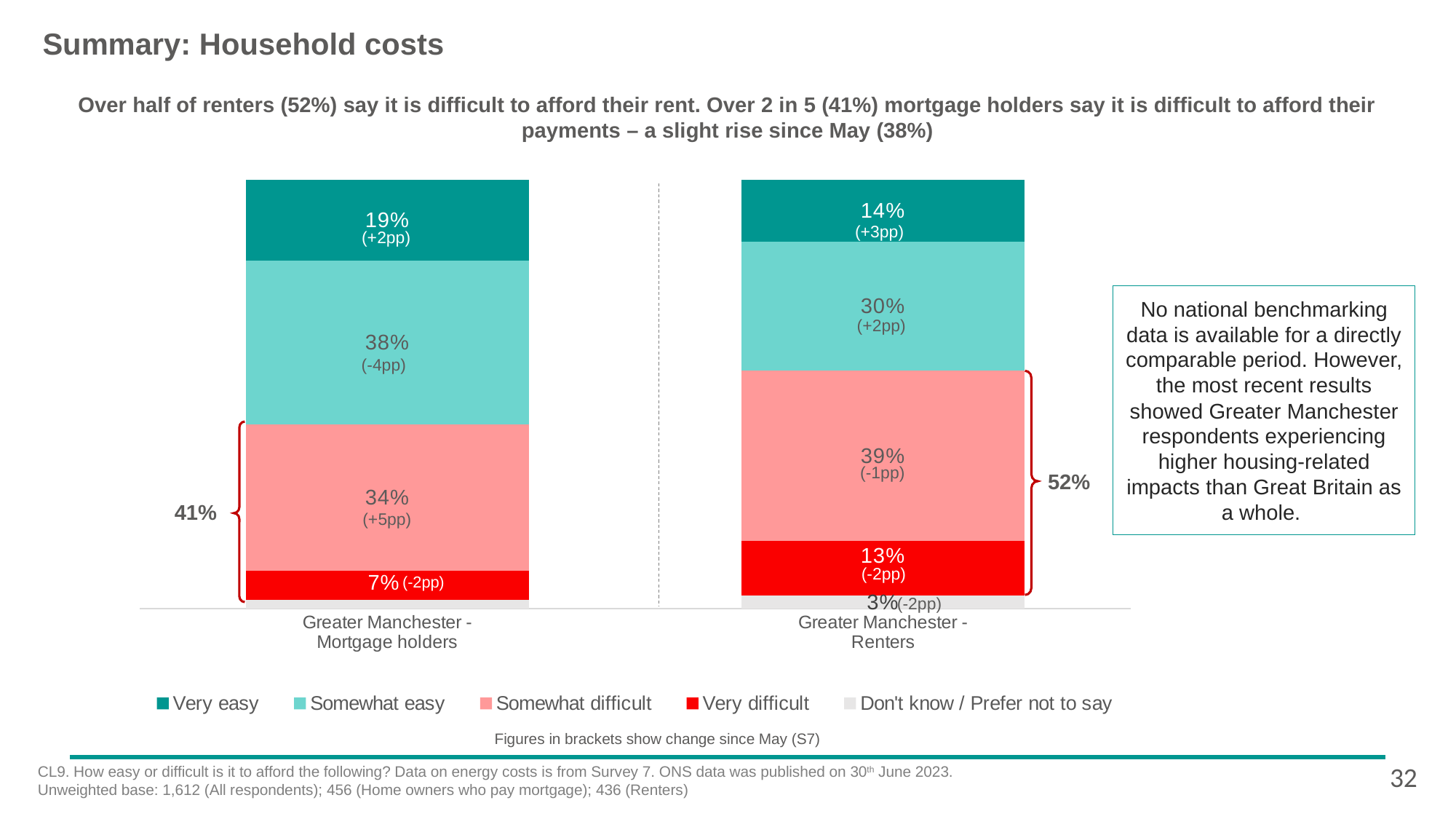
What is the value for 'Very difficult' for Greater Manchester - Renters? 13% How many categories (bars) are plotted on the chart? 2 What change since May is shown in brackets for 'Somewhat difficult' among Mortgage holders? +5pp What is the value for 'Very easy' for Greater Manchester - Mortgage holders? 19% What is the value for 'Somewhat difficult' for Greater Manchester - Renters? 39% Which category has the higher 'Very difficult' value, Mortgage holders or Renters? Greater Manchester - Renters How many series does the legend list? 5 What is the difference between the 'Somewhat easy' values for Mortgage holders and Renters? 8 percentage points What is the combined share of 'Somewhat difficult' and 'Very difficult' for Greater Manchester - Renters, as shown by the bracket? 52% What is the value for 'Somewhat easy' for Greater Manchester - Mortgage holders? 38% What kind of chart is shown on the slide? Stacked bar chart What is the value for 'Don't know / Prefer not to say' for Greater Manchester - Renters? 3%